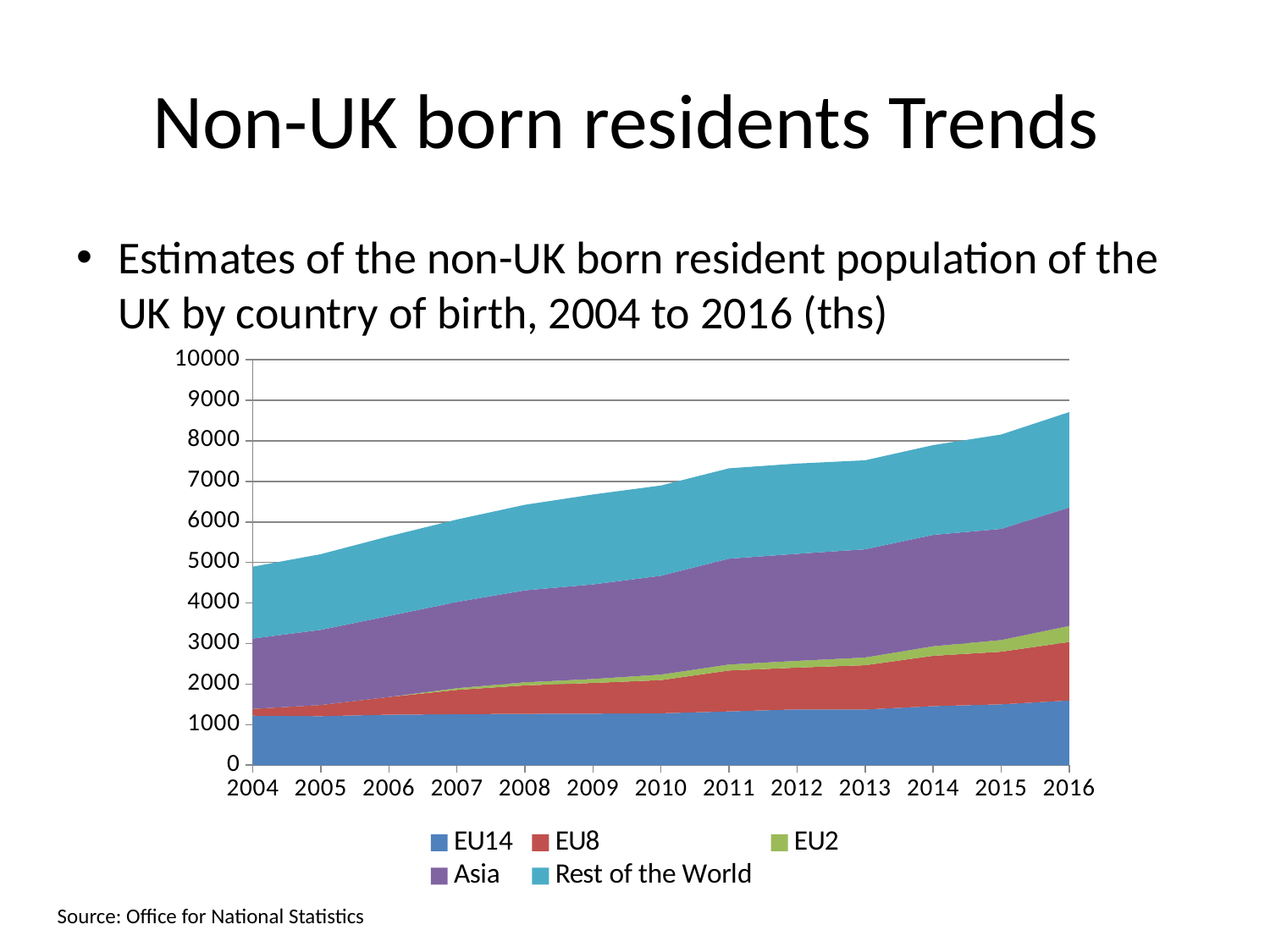
How many series does the legend list? 5 Which year has the lowest total non-UK born resident population? 2004 What kind of chart is shown on the slide? Stacked area chart Does the total non-UK born resident population rise or fall from 2004 to 2016? Rise Is the value for EU14 in 2016 greater or less than 2000? less Which year has the highest total non-UK born resident population? 2016 Which series is shown in purple in the legend? Asia Is the total for 2012 greater or less than 7000? greater Is the total for 2004 greater or less than 6000? less Which is larger in 2016, the EU14 value or the EU2 value? EU14 How many years are plotted along the x axis? 13